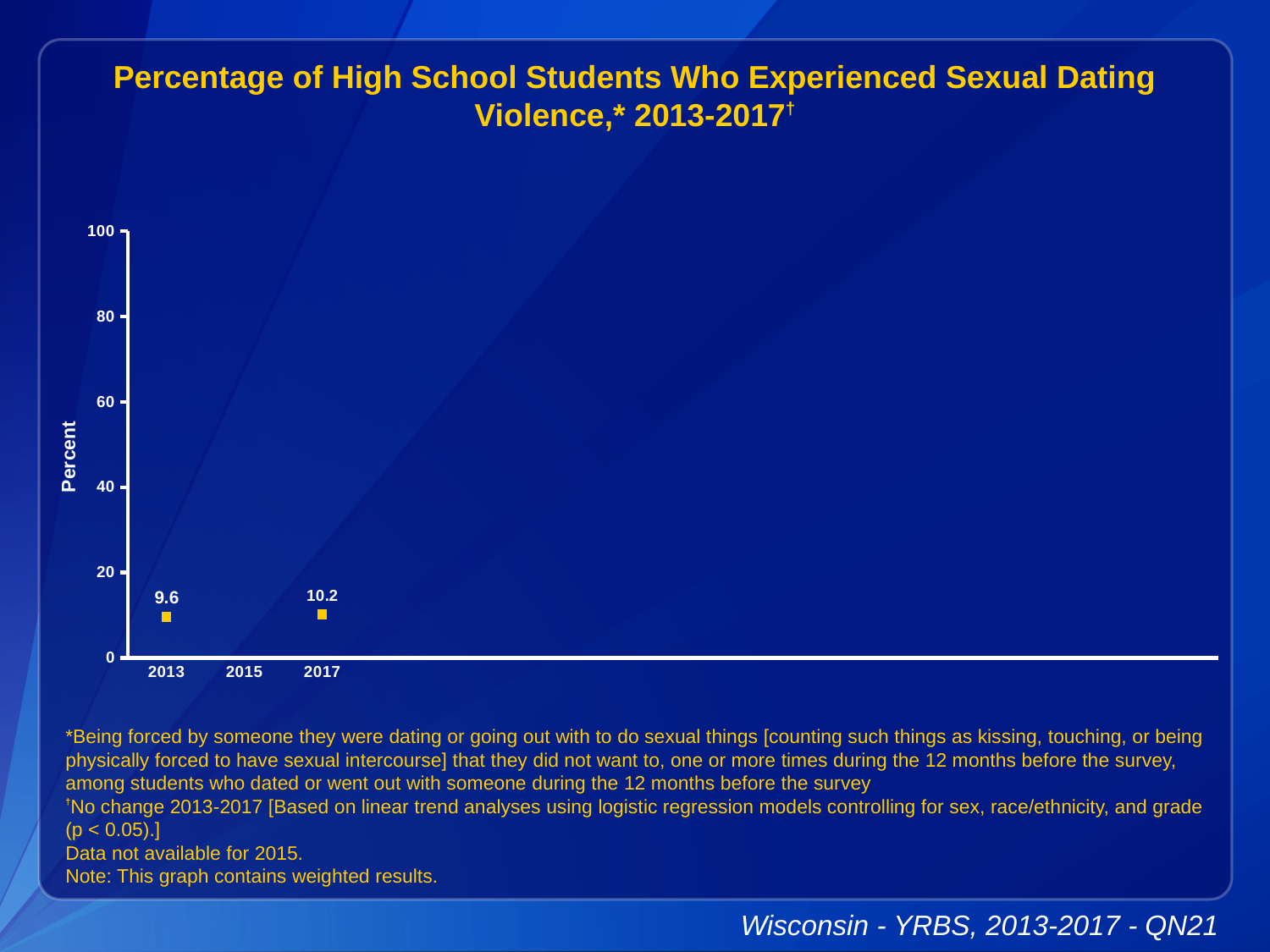
Is the value for 2017 greater or less than 20? less Which year has the lowest plotted value? 2013 What is the label on the y axis? Percent What is the value for 2017? 10.2 Which is larger, the value for 2013 or the value for 2017? 2017 Which year has the highest value? 2017 What is the difference between the values for 2017 and 2013? 0.6 How many data points are plotted on the chart? 2 Do the plotted values rise or fall from 2013 to 2017? rise What is the maximum value shown on the y axis? 100 What is the value for 2013? 9.6 For which year on the x axis is no data point plotted? 2015